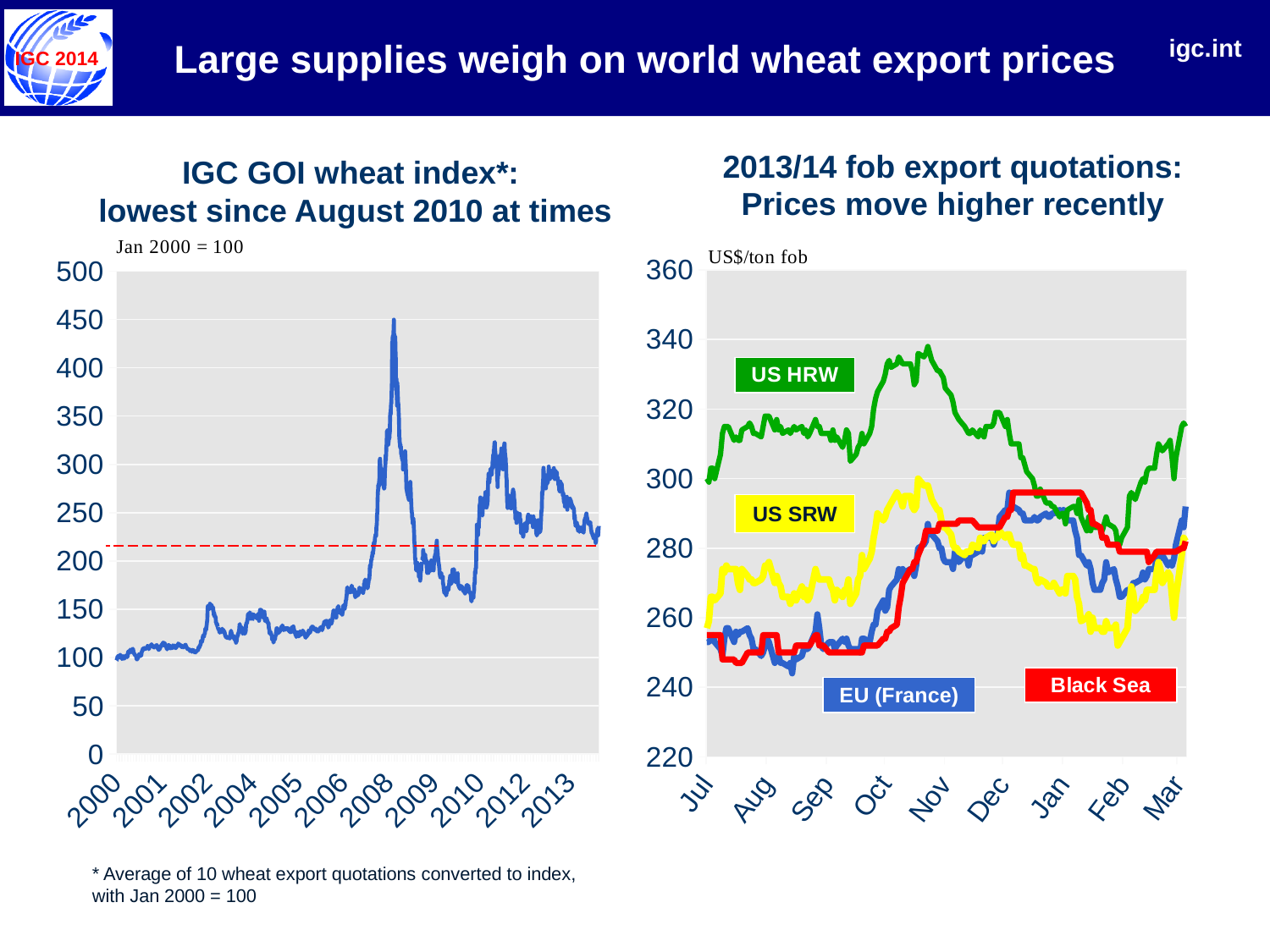
What unit is shown on the y axis of the right chart, '2013/14 fob export quotations'? US$/ton fob In the left chart, 'IGC GOI wheat index', is the peak value around 2008 greater or less than 400? greater In the right chart, '2013/14 fob export quotations', which series has the highest price in Jul? US HRW In the right chart, '2013/14 fob export quotations', how many month labels are on the x axis? 9 What kind of chart is the right chart, '2013/14 fob export quotations'? line chart In the left chart, 'IGC GOI wheat index', does the index rise or fall from 2012 to 2013? fall In the right chart, '2013/14 fob export quotations', which series has the lowest price in Feb? US SRW In the right chart, '2013/14 fob export quotations', which series is labelled in red? Black Sea In the left chart, 'IGC GOI wheat index', what is the index value for Jan 2000? 100 In the right chart, '2013/14 fob export quotations', how many series are labelled? 4 In the right chart, '2013/14 fob export quotations', is the US HRW peak in Nov greater or less than 320? greater What kind of chart is the left chart, 'IGC GOI wheat index'? line chart